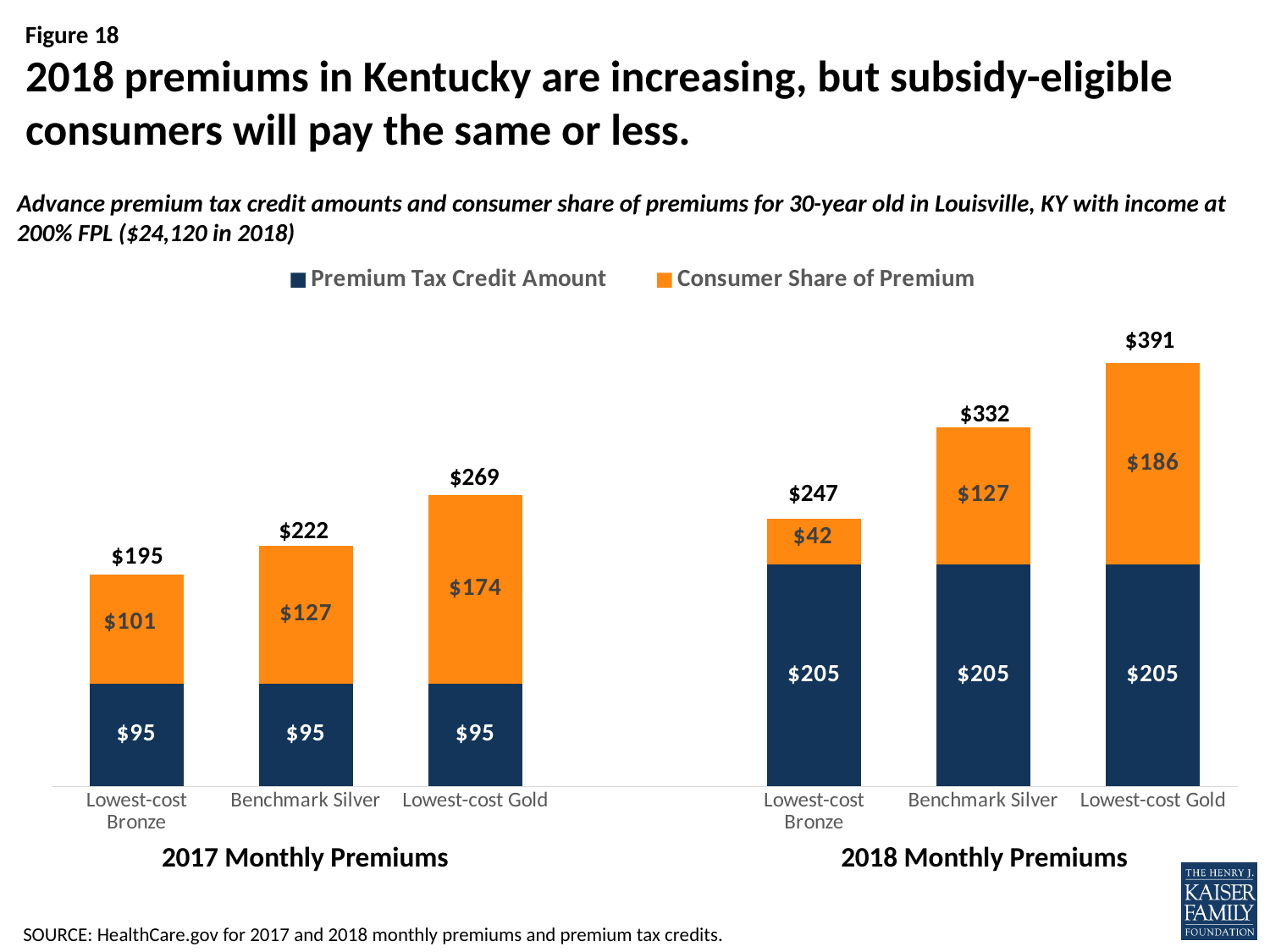
Is the Consumer Share of Premium for Benchmark Silver larger in the 2017 chart or the 2018 chart? They are the same ($127) In the 2018 Monthly Premiums chart, what is the Premium Tax Credit Amount for Lowest-cost Gold? $205 How many series does the legend list? 2 Which colour represents the Consumer Share of Premium in the legend? Orange In the 2018 Monthly Premiums chart, what is the Consumer Share of Premium for Lowest-cost Bronze? $42 How many plan categories are shown in the 2018 Monthly Premiums chart? 3 In the 2018 Monthly Premiums chart, what is the difference between the total premiums for Lowest-cost Gold and Lowest-cost Bronze? $144 In the 2017 Monthly Premiums chart, what is the Premium Tax Credit Amount for Benchmark Silver? $95 In the 2018 Monthly Premiums chart, which plan has the highest total monthly premium? Lowest-cost Gold In the 2017 Monthly Premiums chart, which plan has the lowest Consumer Share of Premium? Lowest-cost Bronze In the 2017 Monthly Premiums chart, what is the total monthly premium for Lowest-cost Gold? $269 What type of chart is used on this slide? Stacked bar chart